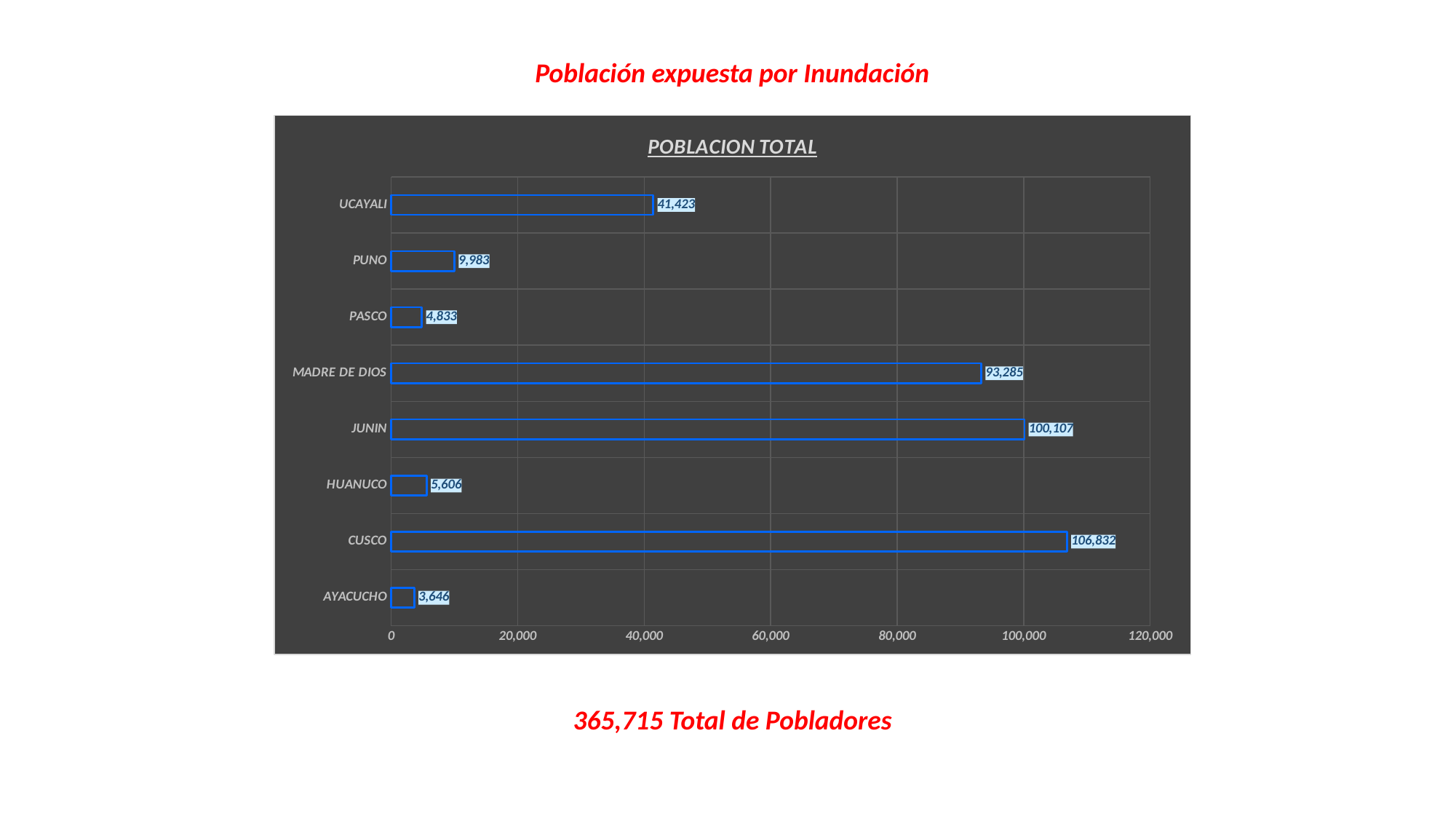
How many categories are shown in the chart? 8 Which category has the highest value? CUSCO What is the difference between the values for UCAYALI and PUNO? 31,440 What is the difference between the values for CUSCO and JUNIN? 6,725 What kind of chart is shown on the slide? bar chart Which is larger, the value for HUANUCO or the value for PASCO? HUANUCO What is the title of the chart? POBLACION TOTAL What is the value for PUNO? 9,983 What is the value for CUSCO in the POBLACION TOTAL chart? 106,832 Which category has the lowest value? AYACUCHO What is the value for MADRE DE DIOS? 93,285 Is the value for JUNIN greater or less than 100,000? greater